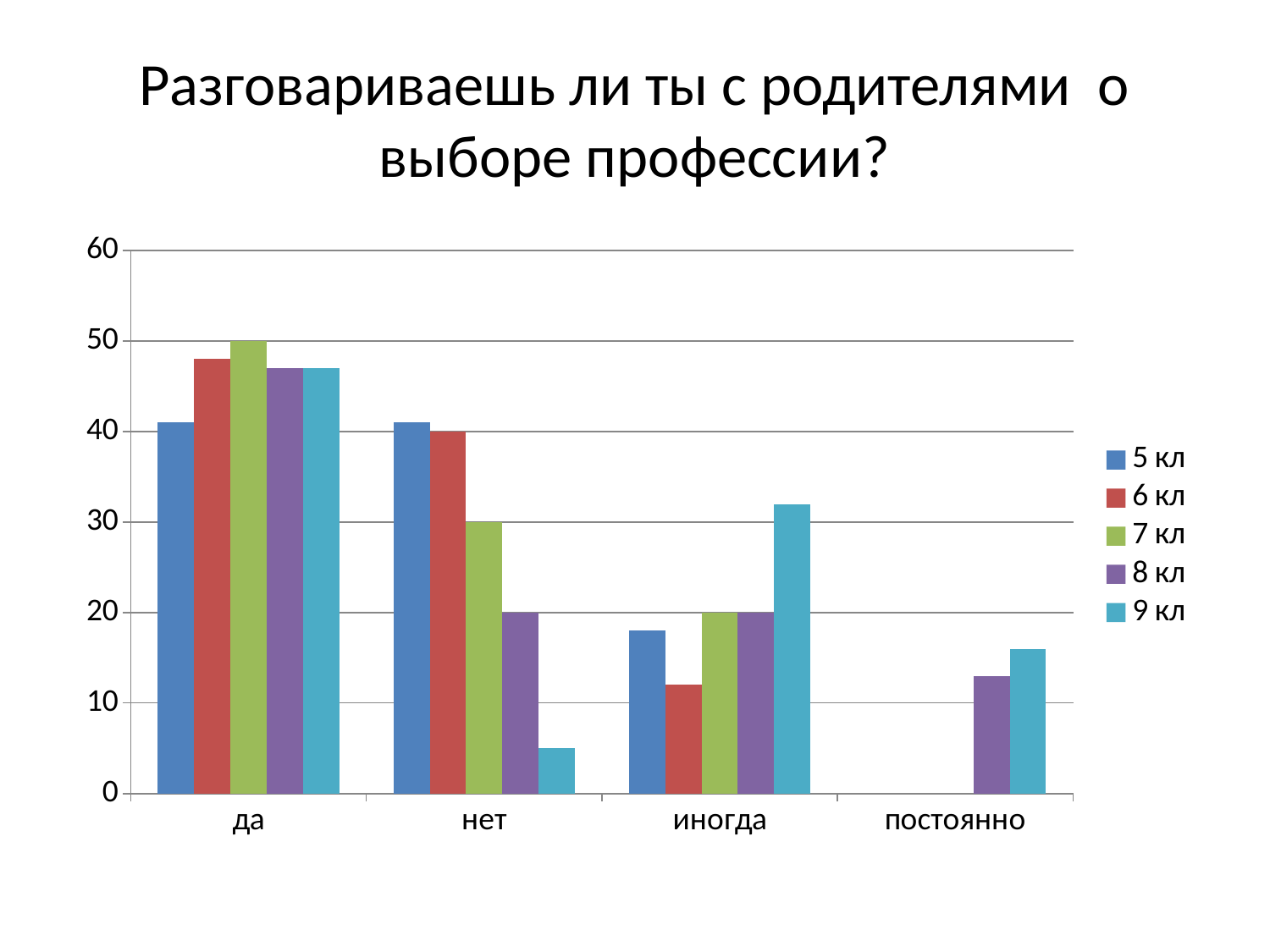
Which is larger in the 'нет' category: 7 кл or 8 кл? 7 кл Which series has the highest value in the 'иногда' category? 9 кл Which series has the lowest value in the 'нет' category? 9 кл Which series has the highest value in the 'да' category? 7 кл What is the title of the chart? Разговариваешь ли ты с родителями о выборе профессии? How many categories are shown on the x axis? 4 Is the value for 5 кл in the 'да' category greater or less than 40? greater Is the value for 9 кл in the 'нет' category greater or less than 10? less How many series does the legend list? 5 Which is larger in the 'постоянно' category: 8 кл or 9 кл? 9 кл Is the value for 9 кл in the 'иногда' category greater or less than 30? greater What kind of chart is shown on the slide? bar chart